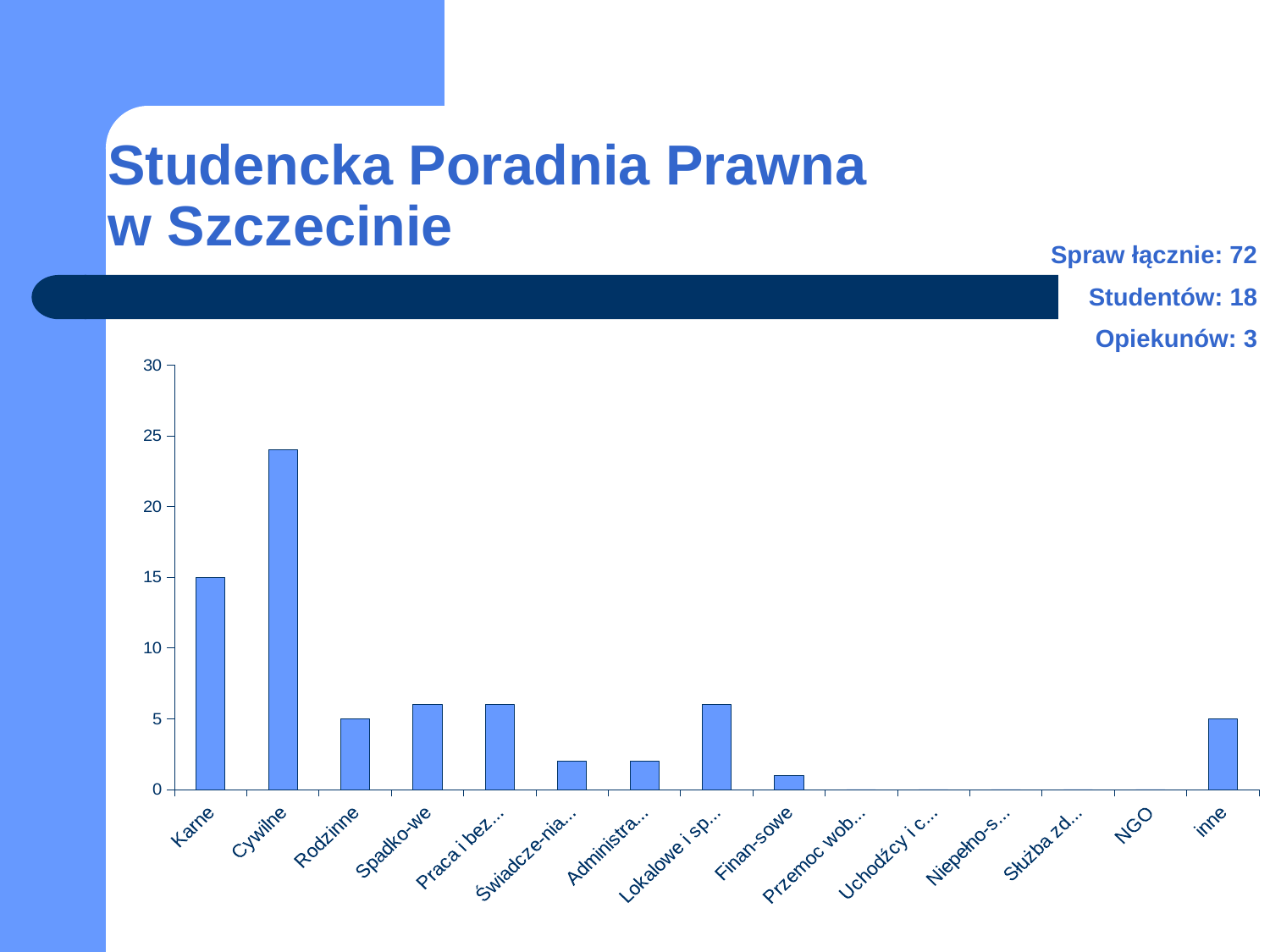
What is the value for Karne? 15 What is the value for inne? 5 How many categories are shown on the x axis? 15 Which is larger, the value for Karne or the value for Cywilne? Cywilne What is the value for NGO? 0 Is the value for Cywilne greater or less than 20? greater What is the value for Rodzinne? 5 Is the value for Spadko-we greater or less than 10? less What kind of chart is shown on the slide? bar chart Which category has the highest bar? Cywilne What is the highest value shown on the y axis? 30 What is the difference between the values for Karne and Rodzinne? 10